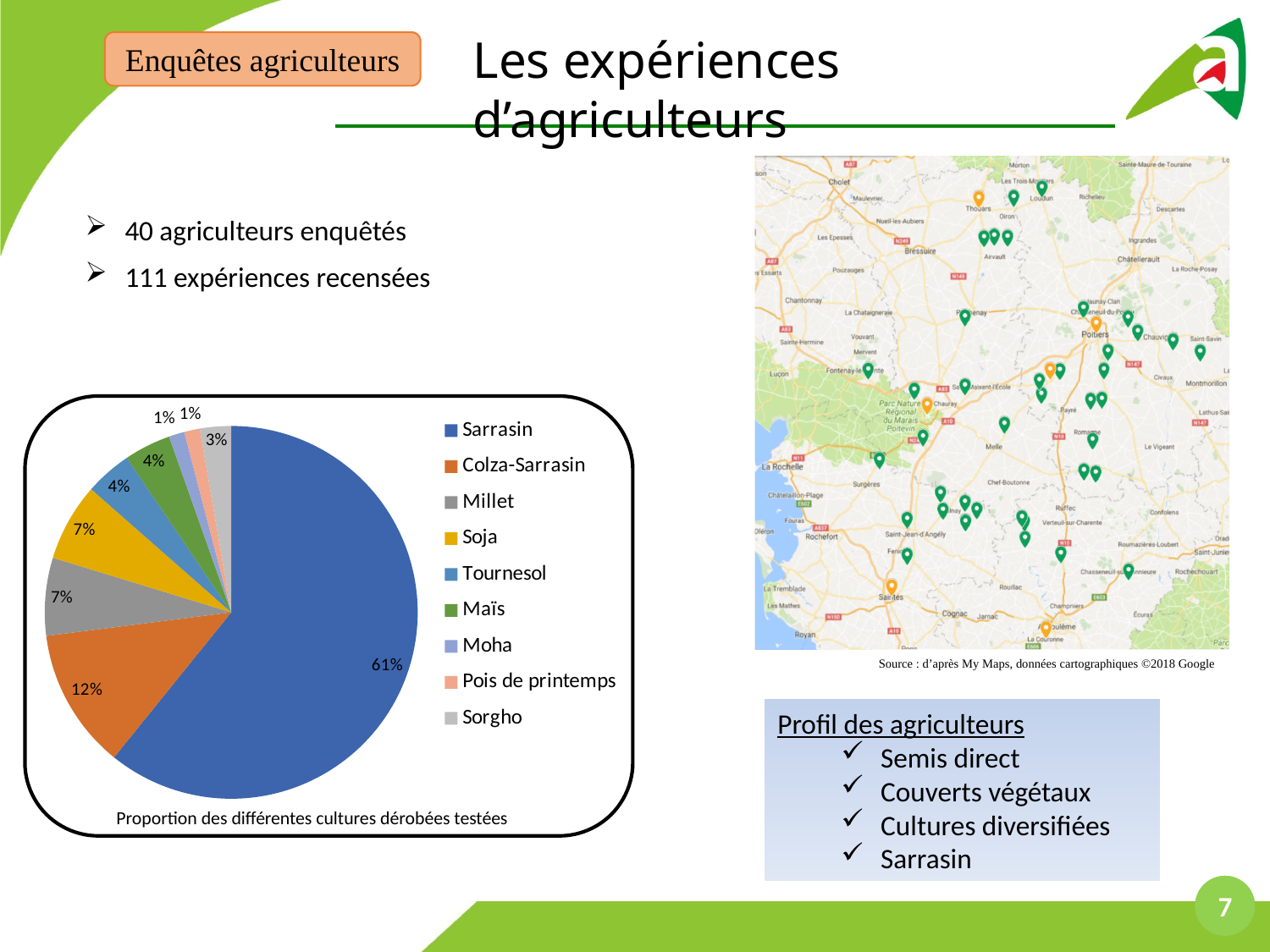
What percentage is shown for Tournesol in the pie chart? 4% How many categories are shown in the pie chart legend? 9 What type of chart is used to show the proportion of cover crops tested? Pie chart What is the title of the pie chart? Proportion des différentes cultures dérobées testées What share of the pie chart does Sarrasin represent? 61% What percentage is shown for Colza-Sarrasin in the pie chart? 12% Which category has the largest slice in the pie chart? Sarrasin What is the difference in percentage points between the Sarrasin slice and the Colza-Sarrasin slice? 49 percentage points What percentage is shown for Sorgho in the pie chart? 3% Which is larger in the pie chart, the share for Colza-Sarrasin or the share for Millet? Colza-Sarrasin Which two categories in the pie chart each have a share of 1%? Moha and Pois de printemps What percentage is shown for Soja in the pie chart? 7%